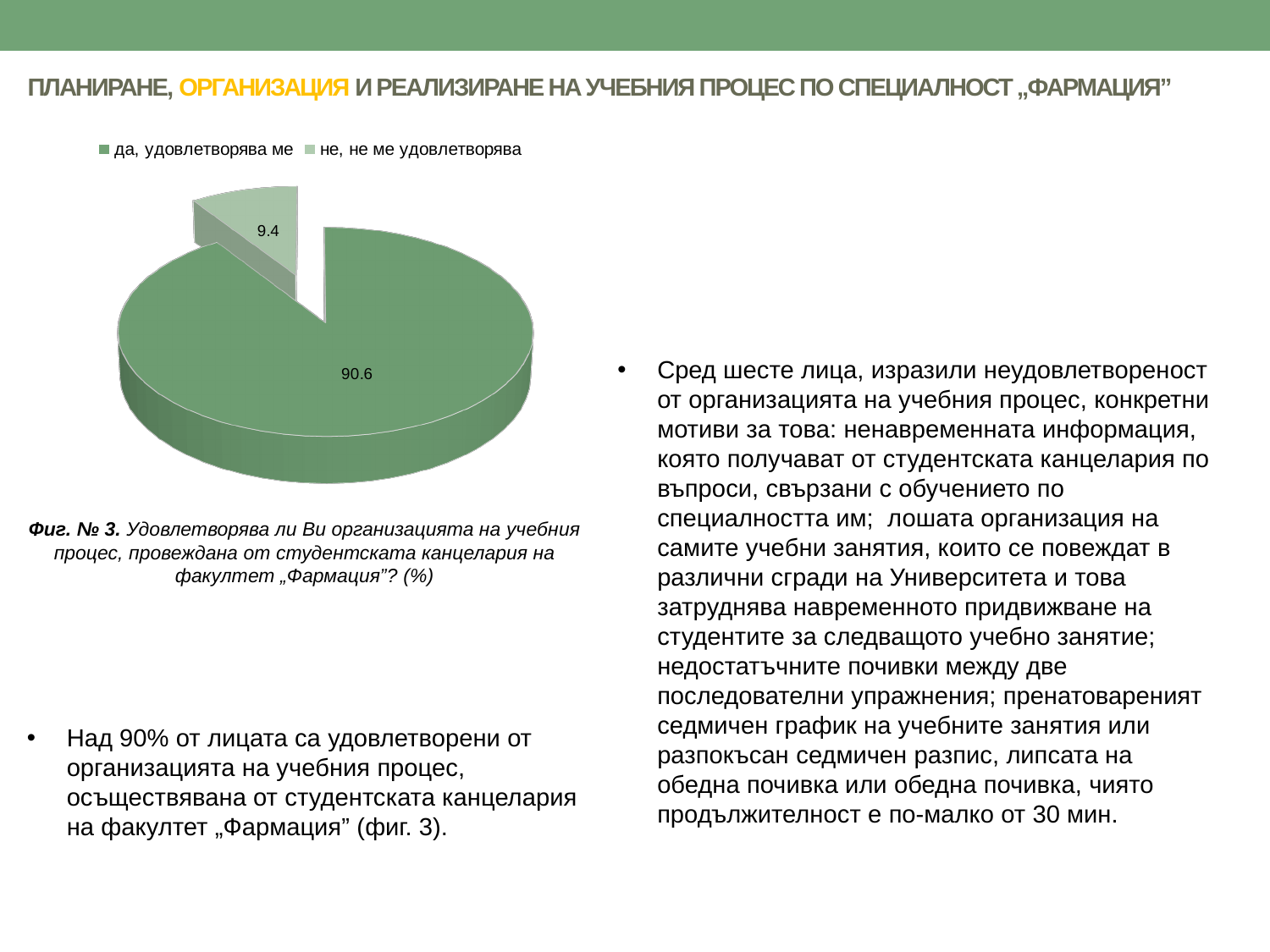
What type of chart is shown on the slide? pie chart Which is larger: the value for "да, удовлетворява ме" or for "не, не ме удовлетворява"? да, удовлетворява ме How many entries does the legend list? 2 Which category has the smallest share of the pie? не, не ме удовлетворява How many slices does the pie chart have? 2 What is the value for "не, не ме удовлетворява"? 9.4 Which slice is pulled out (exploded) from the pie? не, не ме удовлетворява What is the difference between the values for "да, удовлетворява ме" and "не, не ме удовлетворява"? 81.2 What is the total of the two values shown on the pie chart? 100 What is the figure number given in the caption below the chart? Фиг. № 3 What is the value for "да, удовлетворява ме"? 90.6 Which category has the largest share of the pie? да, удовлетворява ме